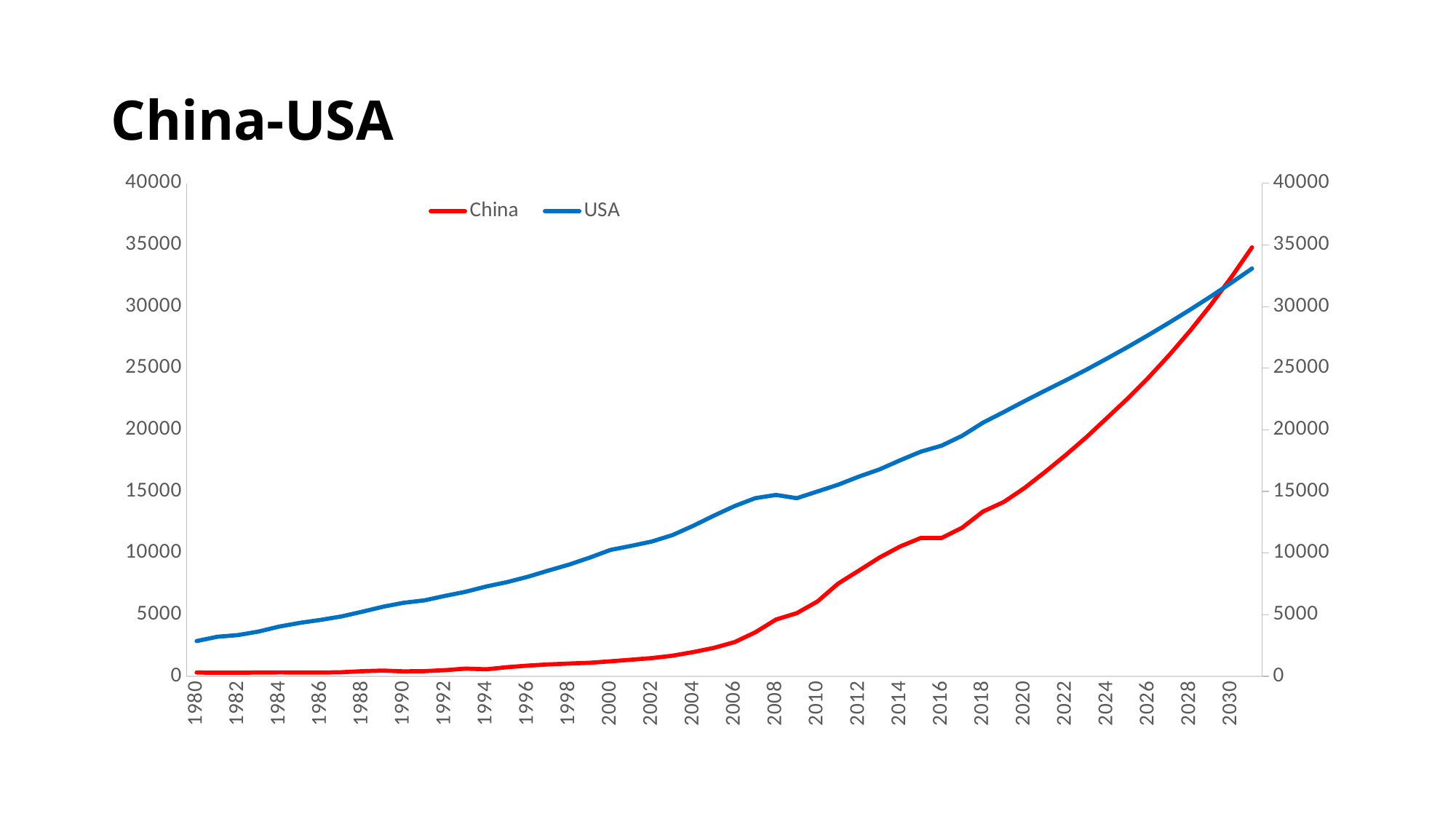
Is the value for USA in 2020 greater or less than 25000? less In 2010, which series has the higher value, China or USA? USA What kind of chart is shown on the slide? line chart Is the value for China in 2020 greater or less than 10000? greater In 2000, which series has the higher value, China or USA? USA What is the title of the chart? China-USA How many series does the legend list? 2 Does the China line rise or fall from 1980 to the right end of the chart? rise Does the USA line rise or fall overall from 1980 to the right end of the chart? rise Is the value for China in 2000 greater or less than 5000? less Which series is drawn in red? China